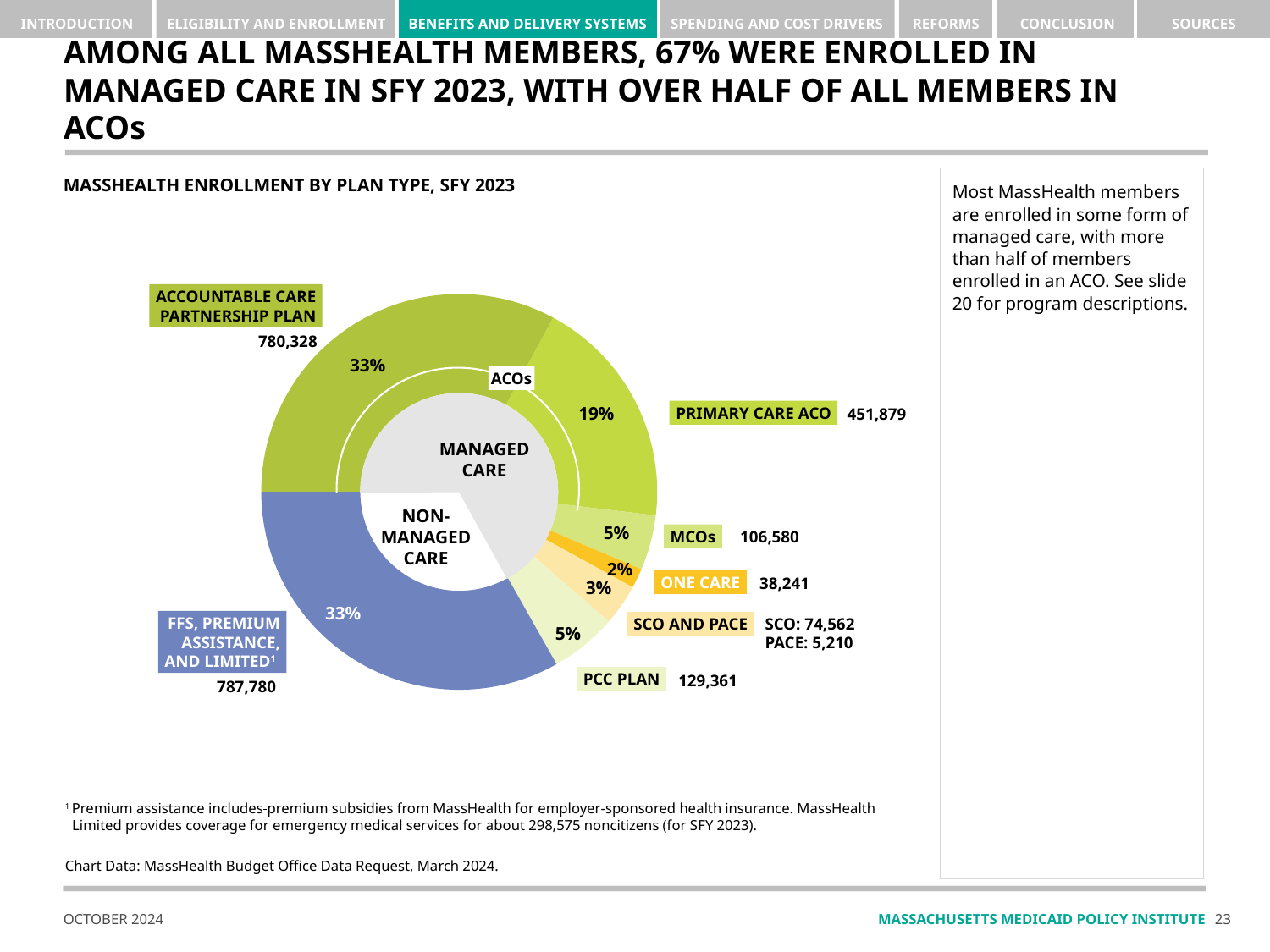
What is the difference between the enrollment for FFS, Premium Assistance, and Limited and the Accountable Care Partnership Plan? 7,452 How many plan-type slices does the chart show? 7 What is the title of the chart on the slide? MassHealth Enrollment by Plan Type, SFY 2023 What kind of chart is shown on the slide? Pie chart (donut) Which plan type has the largest enrollment value shown on the chart? FFS, Premium Assistance, and Limited What is the enrollment value for the PCC Plan? 129,361 Which has a larger enrollment value, the PCC Plan or MCOs? PCC Plan Which plan type has the smallest slice of the chart? One Care What share of the pie does the Primary Care ACO represent? 19% What is the enrollment value for the Primary Care ACO? 451,879 What is the enrollment value for MCOs? 106,580 What is the enrollment value for the Accountable Care Partnership Plan? 780,328